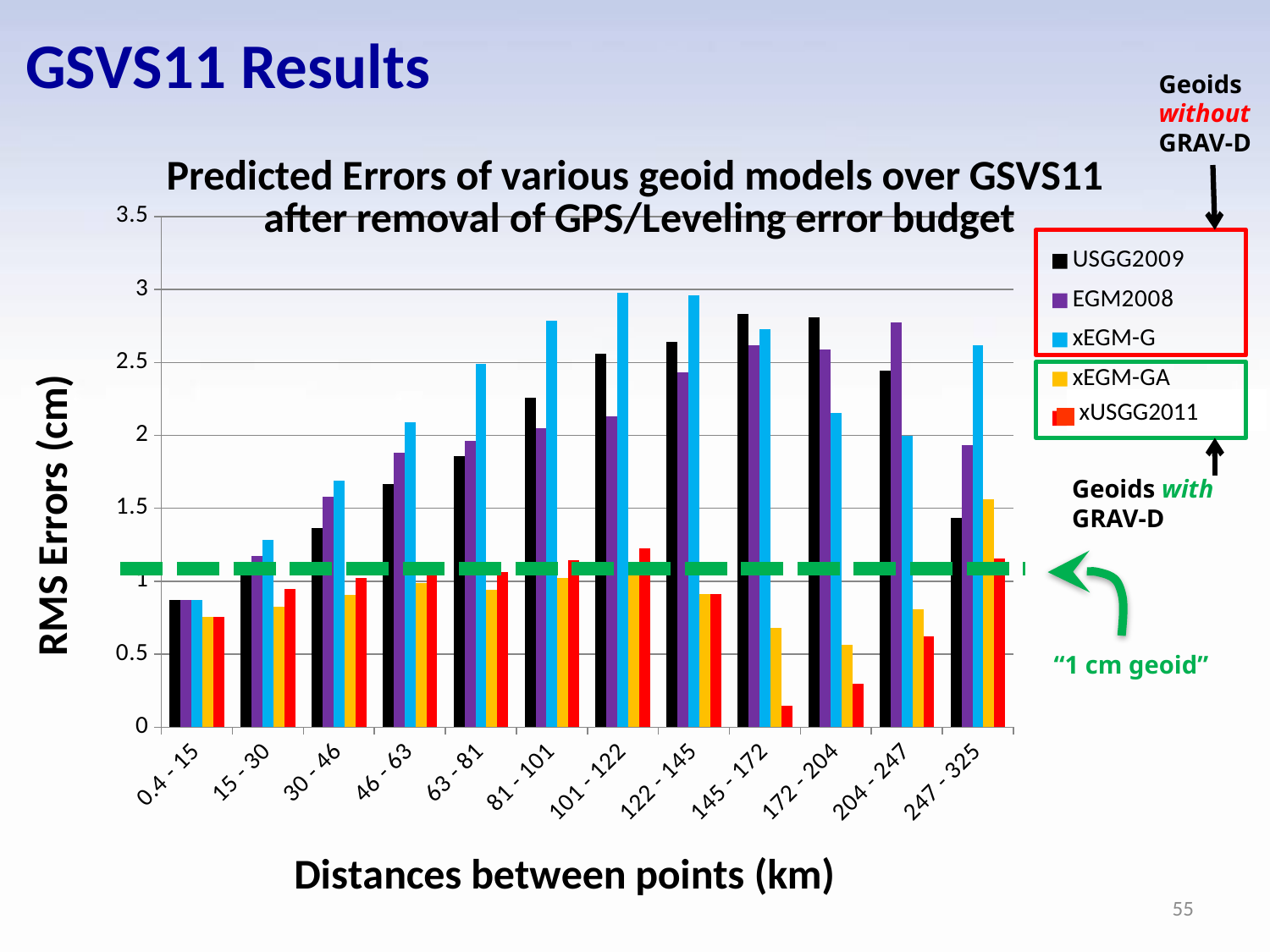
Which series has the highest bar in the 101 - 122 km category? xEGM-G What is the title of the y axis? RMS Errors (cm) Is the value for xEGM-G in the 101 - 122 km category greater or less than 2.5? greater Which series has the lowest bar in the 172 - 204 km category? xUSGG2011 Is the value for xEGM-GA in the 172 - 204 km category greater or less than 1? less How many series does the legend list? 5 Is the value for USGG2009 in the 0.4 - 15 km category greater or less than 1? less Do the xEGM-G values rise or fall from the 0.4 - 15 km category to the 101 - 122 km category? rise What kind of chart is shown on the slide? bar chart How many distance categories are shown on the x axis? 12 In the 145 - 172 km category, which is larger: USGG2009 or xEGM-GA? USGG2009